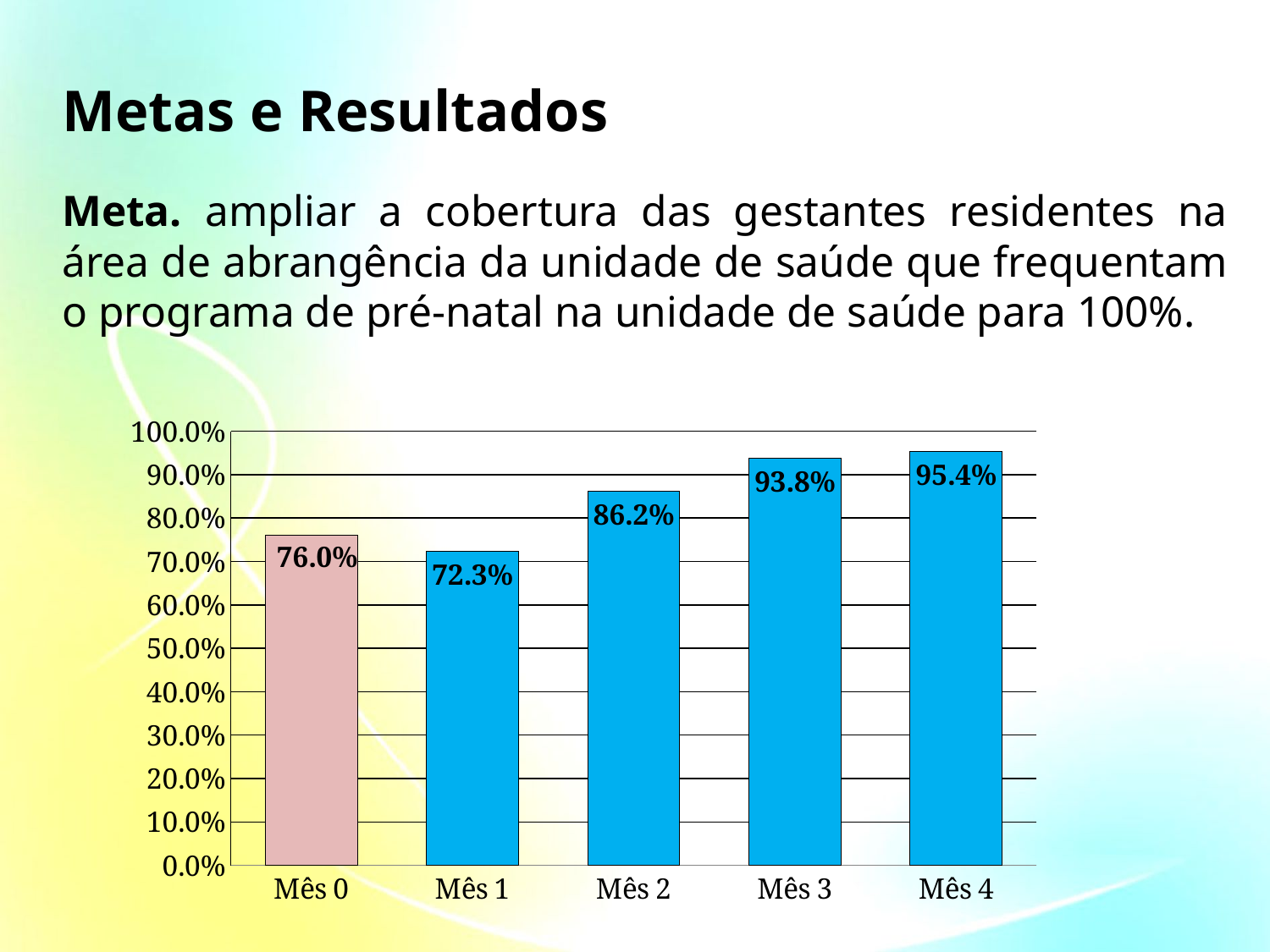
What is the value for Mês 2? 86.2% Which is larger, the value for Mês 0 or the value for Mês 1? Mês 0 Which bar is coloured differently from the others? Mês 0 What is the difference between the values for Mês 4 and Mês 0? 19.4% Which category has the lowest value? Mês 1 How many categories are shown on the x axis? 5 What kind of chart is shown on the slide? bar chart What is the difference between the values for Mês 3 and Mês 2? 7.6% What is the value for Mês 0? 76.0% Which category has the highest value? Mês 4 What is the value for Mês 4? 95.4% Is the value for Mês 3 greater or less than 90.0%? greater